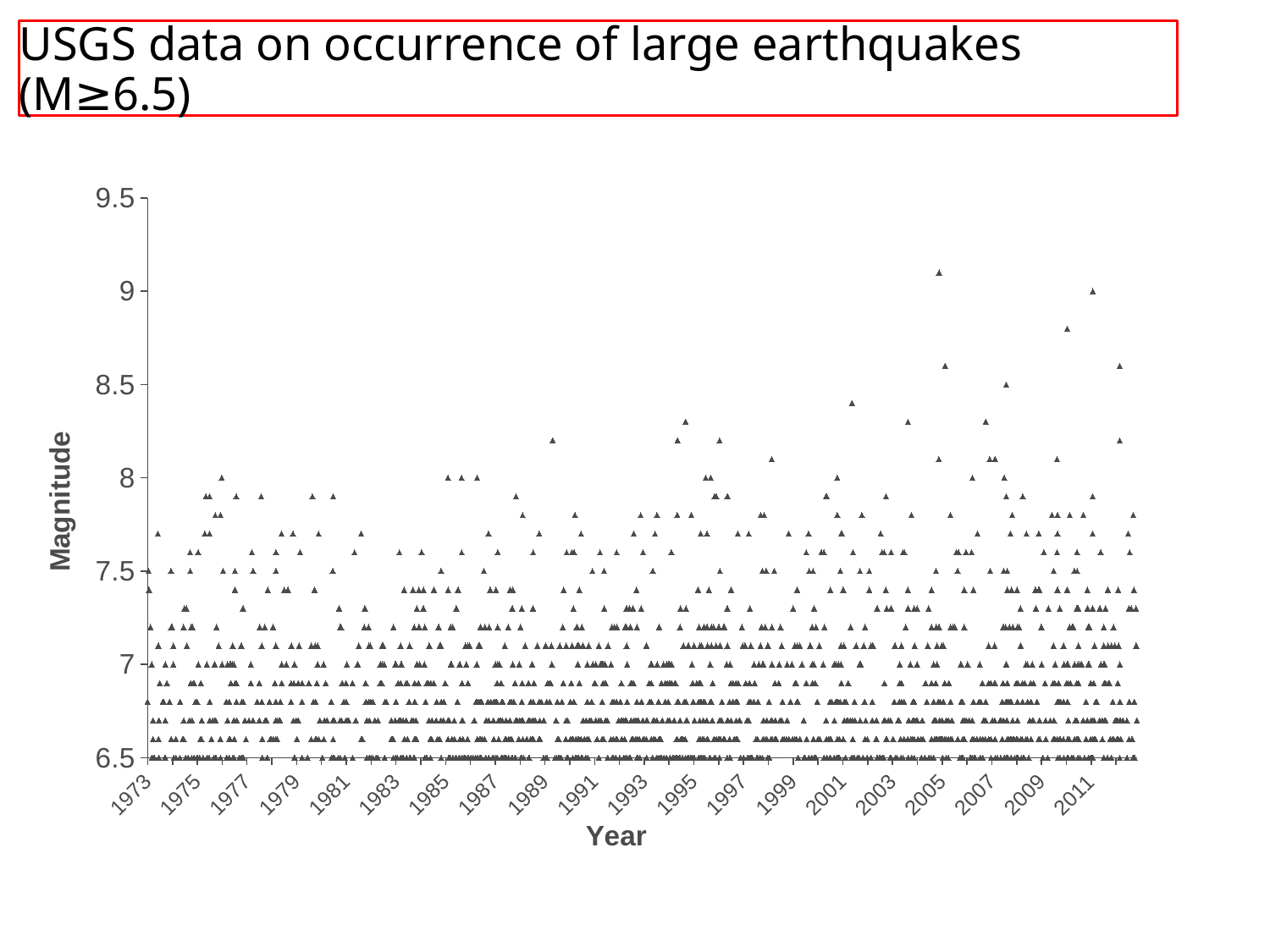
What is the first year labelled on the Year axis? 1973 Is the highest magnitude plotted on the chart greater or less than 8.5? greater What is the highest value shown on the Magnitude axis? 9.5 How many years apart are the labels on the Year axis? 2 What is the lowest value shown on the Magnitude axis? 6.5 Are any points plotted above a magnitude of 9.5? No What is the title of the horizontal axis of the chart? Year How many tick labels are shown on the Magnitude axis? 7 What is the last year labelled on the Year axis? 2011 What kind of chart is shown on the slide? Scatter plot Is the lowest magnitude plotted on the chart greater or less than 7? less What is the title of the vertical axis of the chart? Magnitude